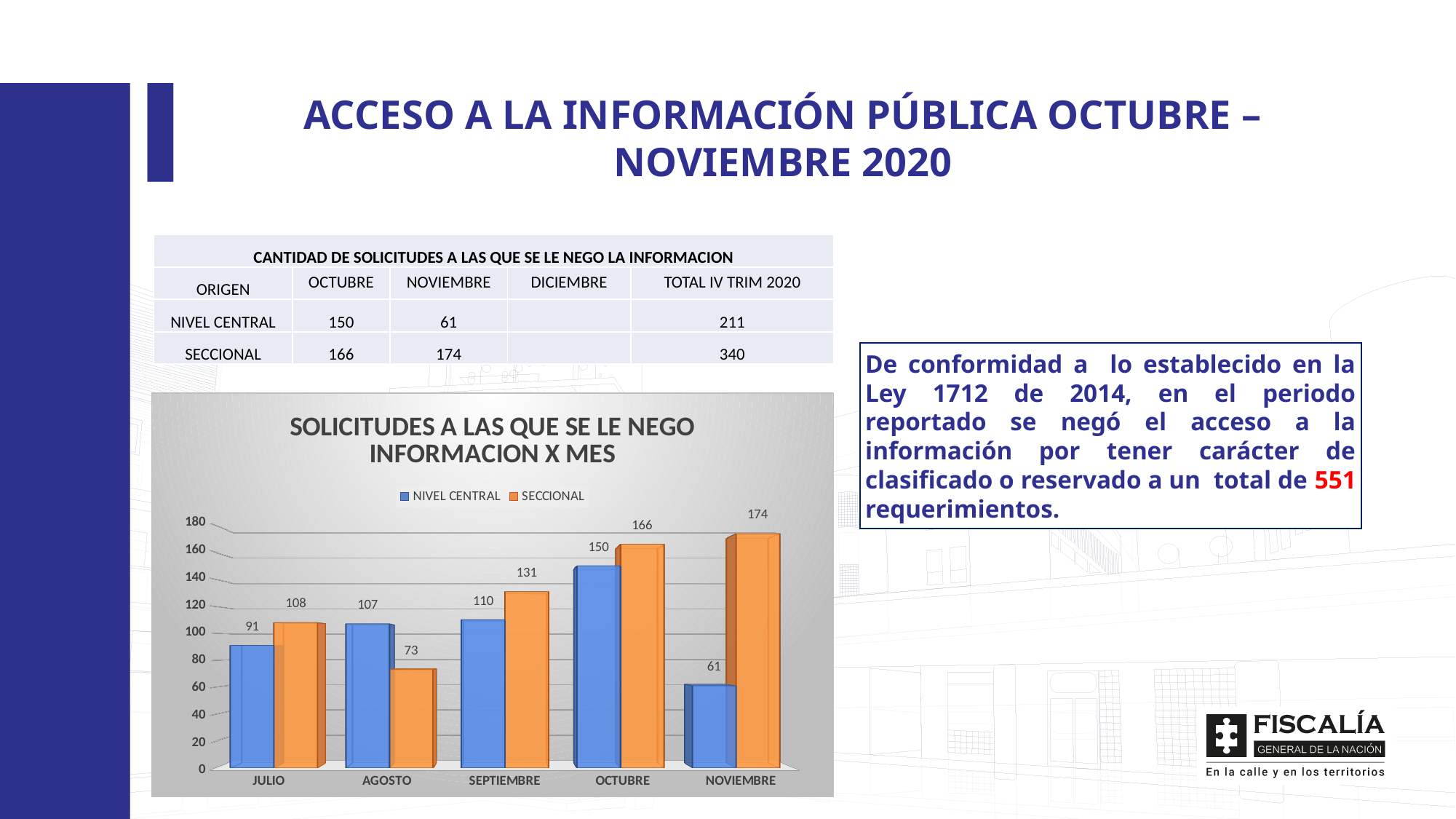
What is the value for NIVEL CENTRAL in OCTUBRE? 150 What kind of chart is shown on the slide? Bar chart What is the value for SECCIONAL in NOVIEMBRE? 174 Which month has the lowest value for NIVEL CENTRAL? NOVIEMBRE What is the title of the chart? SOLICITUDES A LAS QUE SE LE NEGO INFORMACION X MES What is the difference between SECCIONAL and NIVEL CENTRAL in NOVIEMBRE? 113 Which month has the lowest value for SECCIONAL? AGOSTO In AGOSTO, which series is larger, NIVEL CENTRAL or SECCIONAL? NIVEL CENTRAL How many months are shown on the x axis of the chart? 5 What is the value for SECCIONAL in AGOSTO? 73 Which month has the highest value for NIVEL CENTRAL? OCTUBRE How many series does the chart legend list? 2